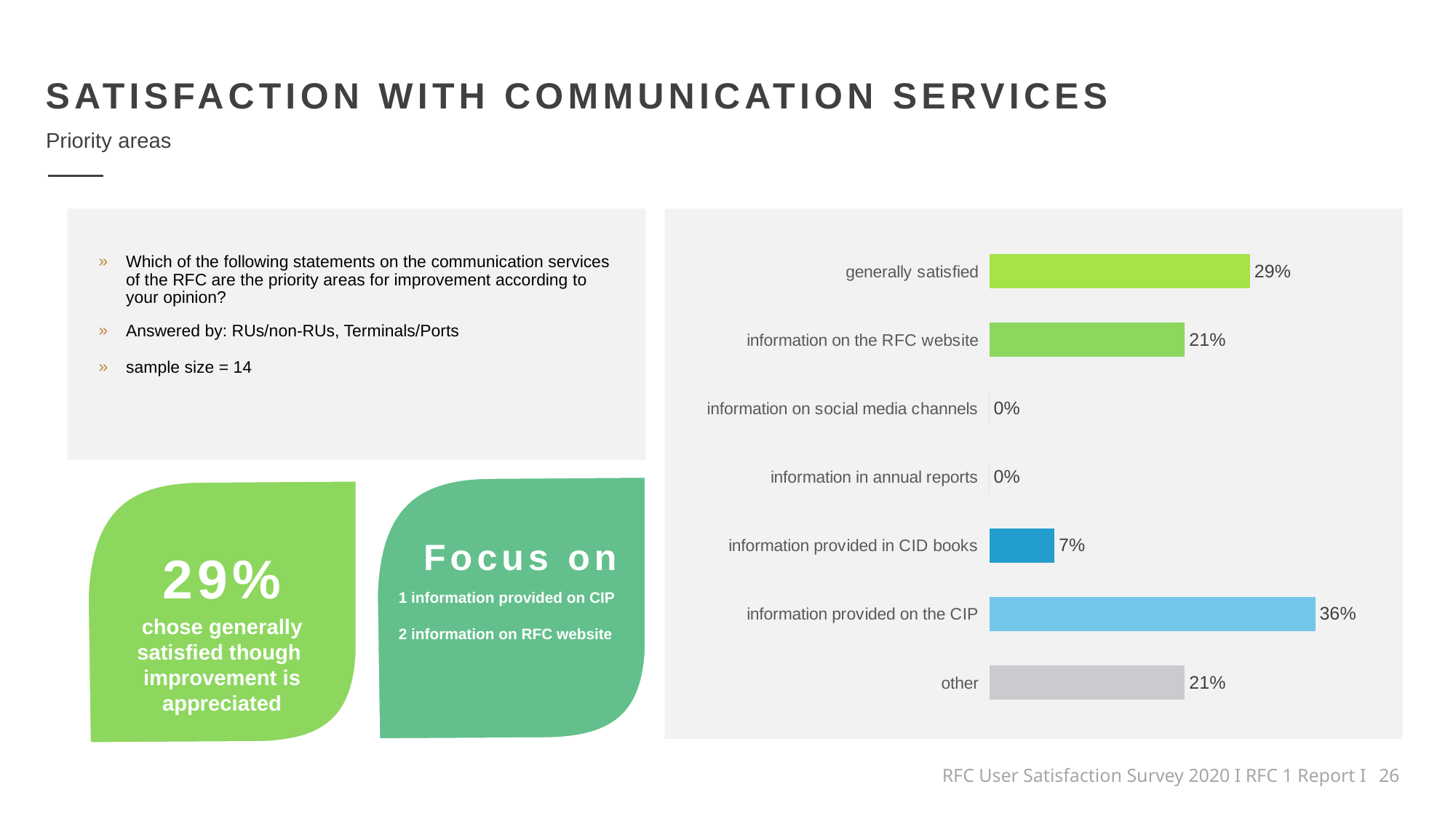
What colour is the bar for 'information provided in CID books'? dark blue How many categories have a value of 0%? 2 What percentage is shown for 'information on social media channels'? 0% What kind of chart is shown on the slide? bar chart What percentage is shown for 'information provided on the CIP'? 36% Which is larger, the value for 'generally satisfied' or the value for 'other'? generally satisfied What is the difference in percentage points between 'information provided on the CIP' and 'generally satisfied'? 7 How many categories are shown in the bar chart? 7 What percentage is shown for 'information provided in CID books'? 7% What percentage is shown for 'generally satisfied'? 29% What is the difference in percentage points between 'information on the RFC website' and 'information provided in CID books'? 14 Which category has the highest percentage? information provided on the CIP